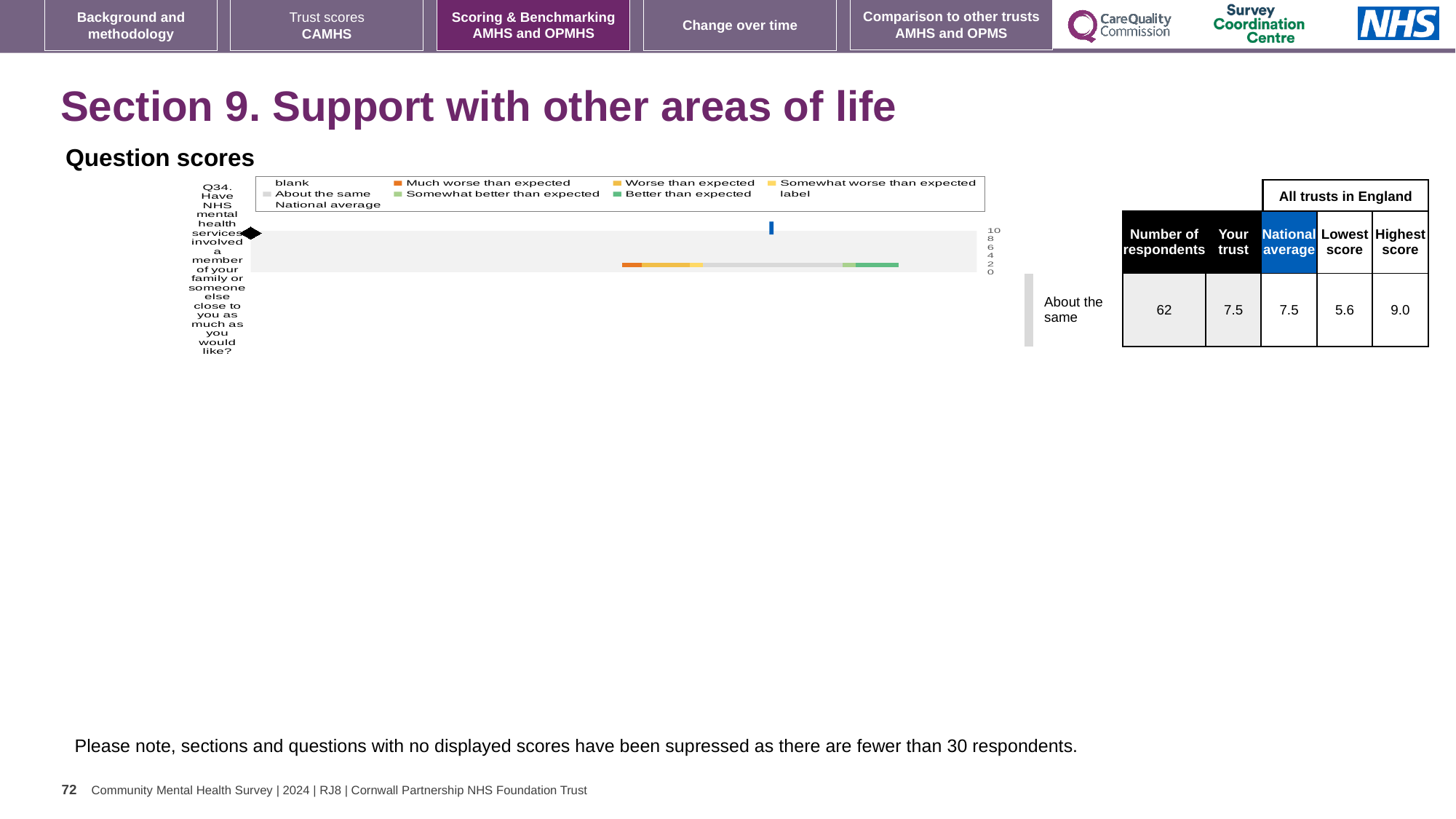
What benchmark category is shown for Q34 next to the chart? About the same Is the 'Your trust' score for Q34 larger or smaller than the lowest score across all trusts? larger What is the highest score among all trusts in England for Q34? 9.0 What is the 'Your trust' score for Q34 in the table beside the chart? 7.5 What is the national average score for Q34 in the table beside the chart? 7.5 What is the difference between the highest and lowest scores for Q34 across all trusts in England? 3.4 What is the lowest score among all trusts in England for Q34? 5.6 What kind of chart is shown under 'Question scores'? bar chart In the chart legend, what colour represents 'Much worse than expected'? orange What is the number of respondents for Q34 in the table beside the chart? 62 How many questions are plotted in the Question scores chart? 1 Which question number is plotted in the Question scores chart? Q34